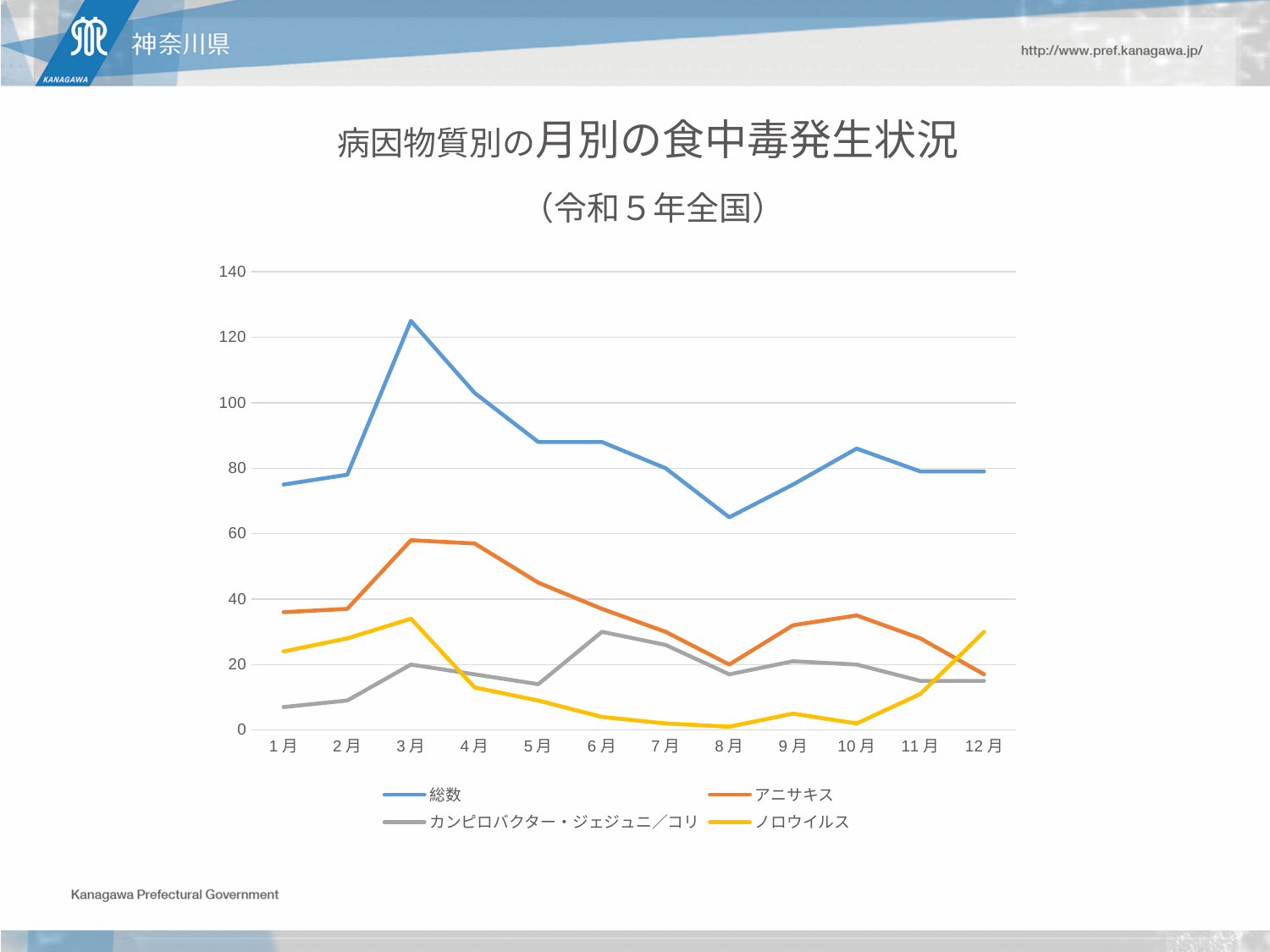
In which month does the 総数 line reach its highest value? 3月 Is the value for アニサキス in 3月 greater or less than 40? greater Which is larger, the ノロウイルス value in 1月 or in 7月? 1月 Is the value for 総数 in 3月 greater or less than 120? greater Does the 総数 line rise or fall from 3月 to 8月? fall How many months are plotted along the x axis? 12 In which month does the ノロウイルス line reach its highest value? 3月 In which month does the 総数 line reach its lowest value? 8月 How many series does the legend list? 4 In which month does the カンピロバクター・ジェジュニ／コリ line reach its highest value? 6月 Is the value for 総数 in 8月 greater or less than 80? less What kind of chart is shown on the slide? line chart